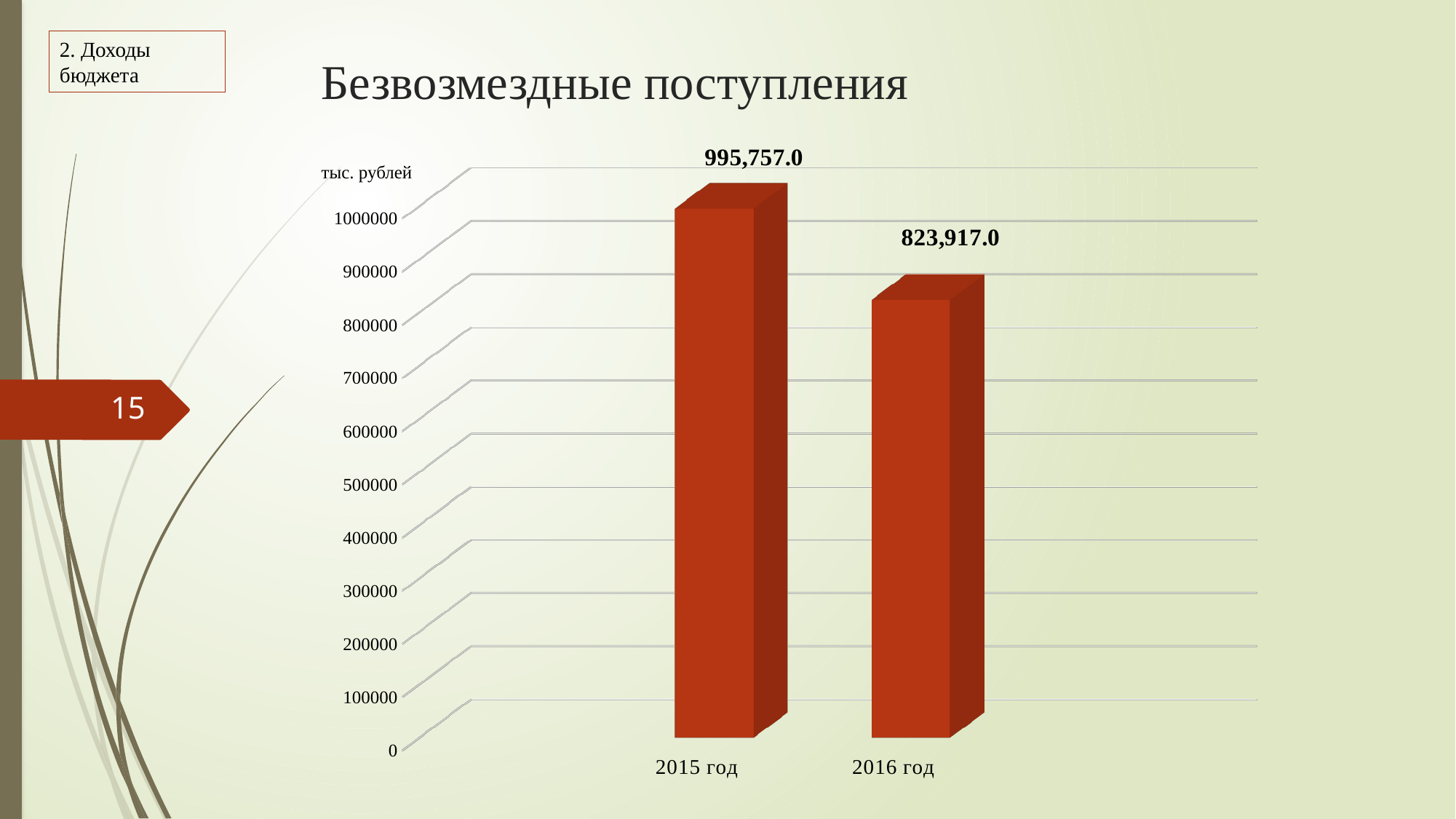
What is the difference between the values for 2015 год and 2016 год? 171,840.0 What is the title of the chart? Безвозмездные поступления Which is larger, the value for 2015 год or the value for 2016 год? 2015 год Is the value for 2016 год greater or less than 900000? less Is the value for 2015 год greater or less than 900000? greater What is the value for 2016 год? 823,917.0 What is the value for 2015 год? 995,757.0 What kind of chart is shown on the slide? bar chart Do the values rise or fall from 2015 год to 2016 год? fall Which year has the highest value? 2015 год How many categories are shown on the x axis? 2 Which year has the lowest value? 2016 год